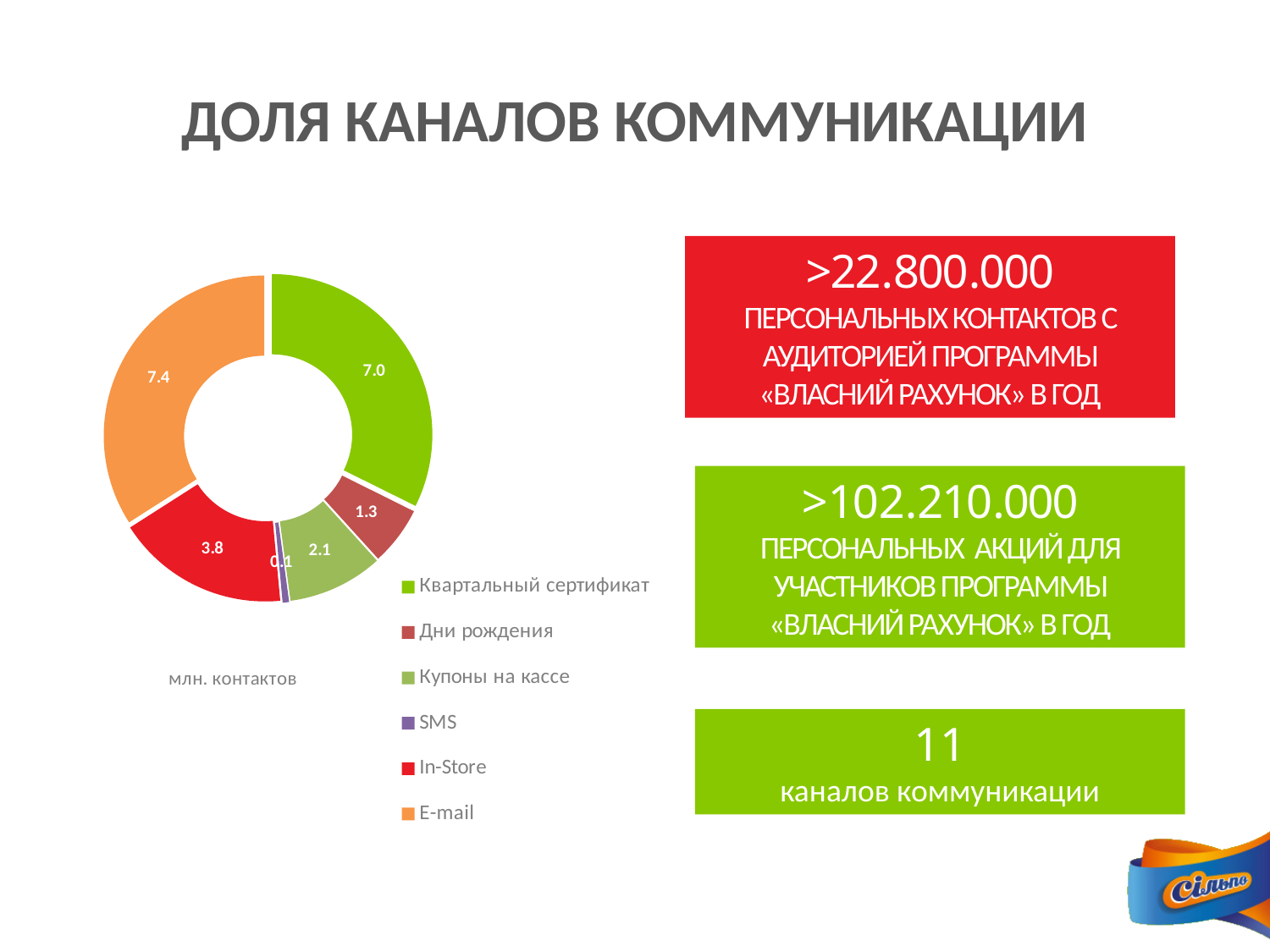
What is the value for In-Store in the doughnut chart? 3.8 What is the value for Квартальный сертификат in the doughnut chart? 7.0 Which is larger, the value for In-Store or the value for Дни рождения? In-Store What unit label is shown below the doughnut chart? млн. контактов What is the value for SMS in the doughnut chart? 0.1 Which channel has the smallest value in the doughnut chart? SMS What is the difference between the values for E-mail and Квартальный сертификат? 0.4 Which channel has the largest value in the doughnut chart? E-mail What is the difference between the values for In-Store and Купоны на кассе? 1.7 What is the value for E-mail in the doughnut chart? 7.4 How many channels (segments) does the doughnut chart show? 6 What kind of chart is shown on the slide? Doughnut (ring) chart